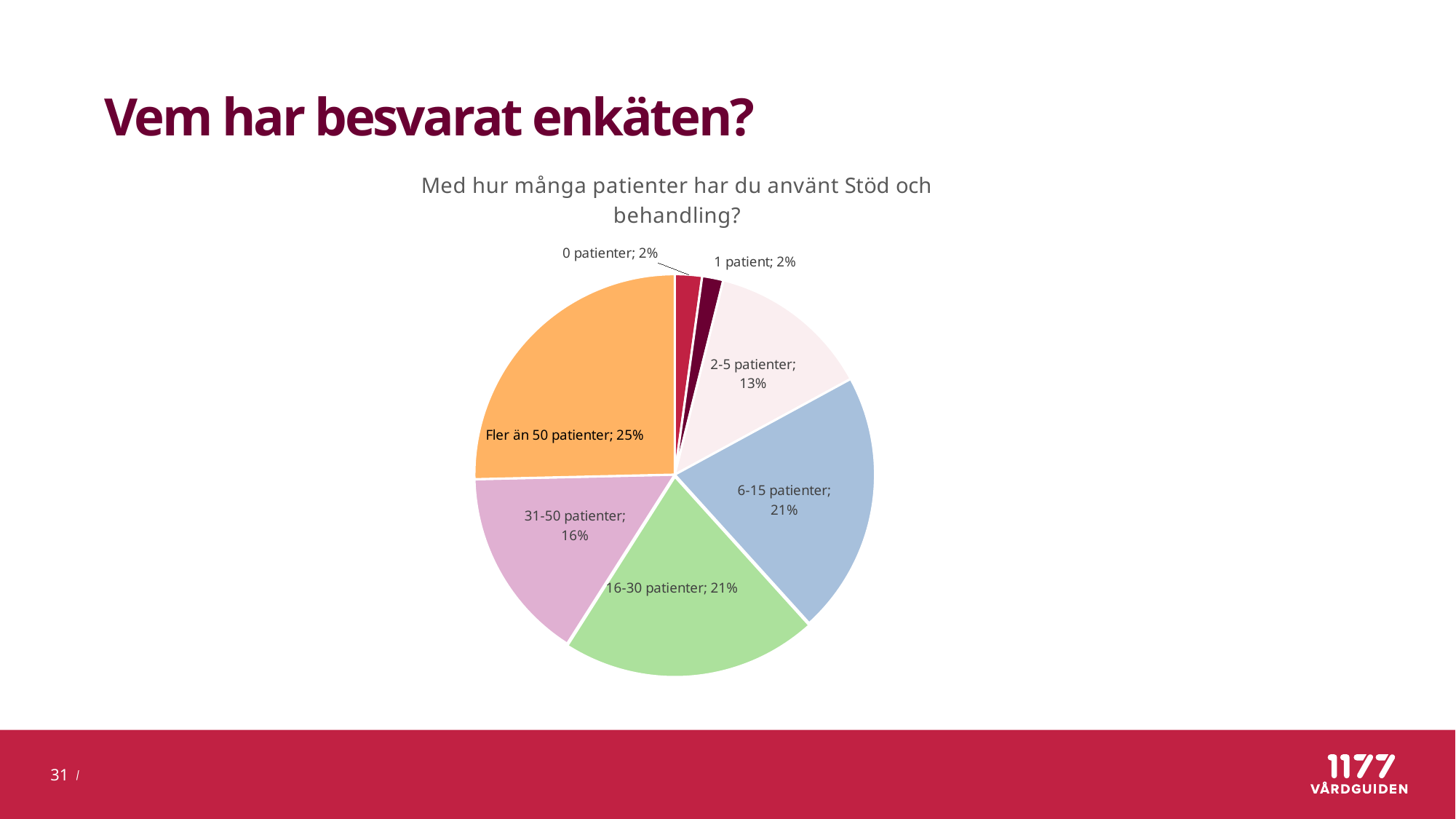
What is the value for "2-5 patienter"? 13% Which is larger, the share for "2-5 patienter" or the share for "31-50 patienter"? 31-50 patienter What share of the pie is "Fler än 50 patienter"? 25% What is the value for "6-15 patienter"? 21% What is the chart's title? Med hur många patienter har du använt Stöd och behandling? What is the difference between the shares of "Fler än 50 patienter" and "31-50 patienter"? 9 percentage points What is the value for "31-50 patienter"? 16% How many slices does the pie chart have? 7 Which category has the largest share of the pie? Fler än 50 patienter What colour is the "16-30 patienter" slice? green What kind of chart is shown on the slide? pie chart What is the value for "0 patienter"? 2%